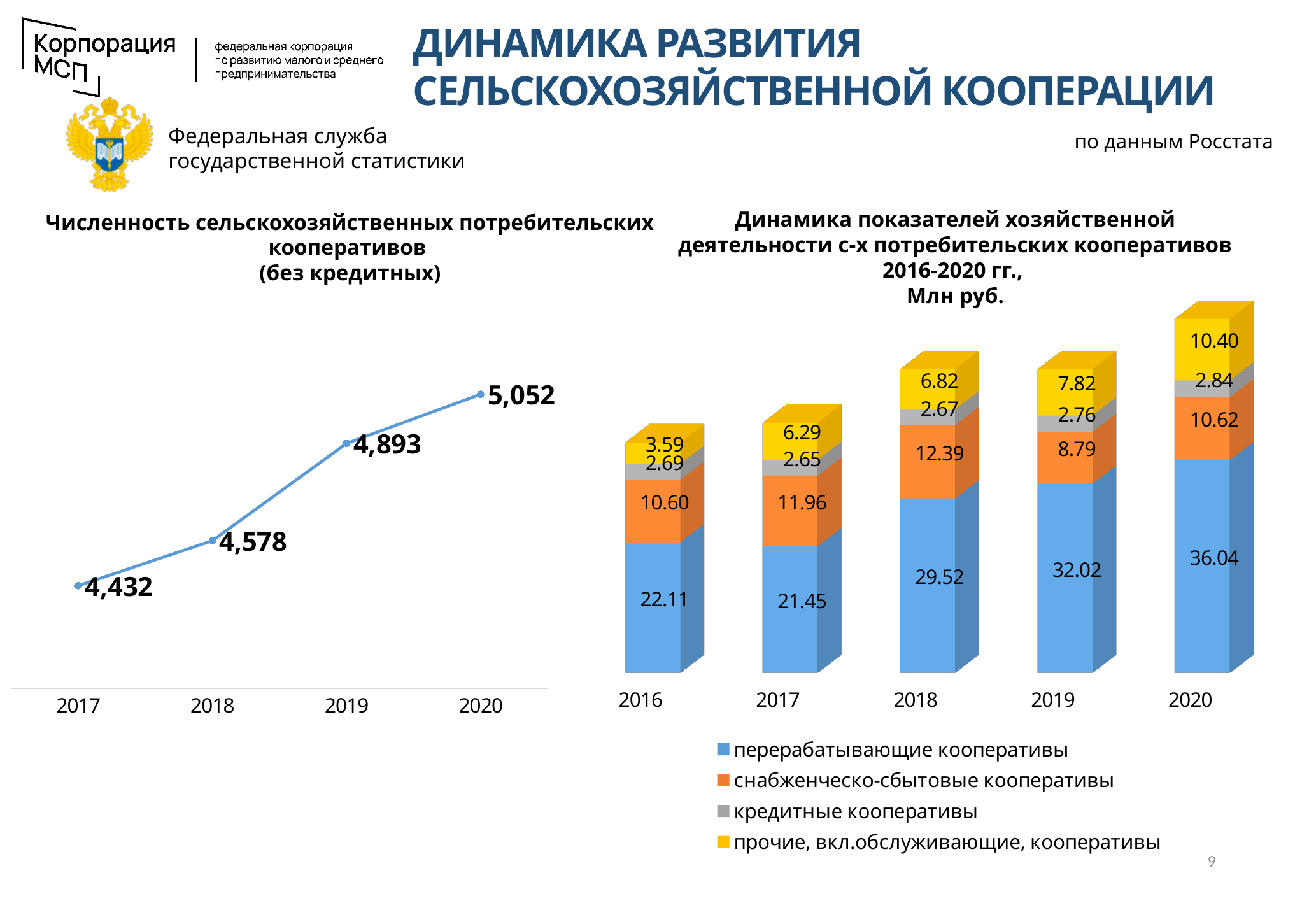
In the left chart (Численность сельскохозяйственных потребительских кооперативов), what is the value for 2018? 4,578 In the right chart (Динамика показателей хозяйственной деятельности), which is larger: снабженческо-сбытовые кооперативы in 2018 or in 2019? 2018 In the left chart (Численность сельскохозяйственных потребительских кооперативов), which year has the lowest value? 2017 In the right chart (Динамика показателей хозяйственной деятельности), how many years are shown on the x axis? 5 In the right chart (Динамика показателей хозяйственной деятельности), what is the value for перерабатывающие кооперативы in 2019? 32.02 In the left chart (Численность сельскохозяйственных потребительских кооперативов), do the values rise or fall from 2017 to 2020? rise In the left chart (Численность сельскохозяйственных потребительских кооперативов), what is the difference between the 2020 and 2017 values? 620 What kind of chart is the left chart (Численность сельскохозяйственных потребительских кооперативов)? line chart In the left chart (Численность сельскохозяйственных потребительских кооперативов), what is the value for 2020? 5,052 In the right chart (Динамика показателей хозяйственной деятельности), what is the total of the stacked bar for 2016? 38.99 In the right chart (Динамика показателей хозяйственной деятельности), what is the value for прочие, вкл.обслуживающие, кооперативы in 2020? 10.40 In the right chart (Динамика показателей хозяйственной деятельности), how many series does the legend list? 4